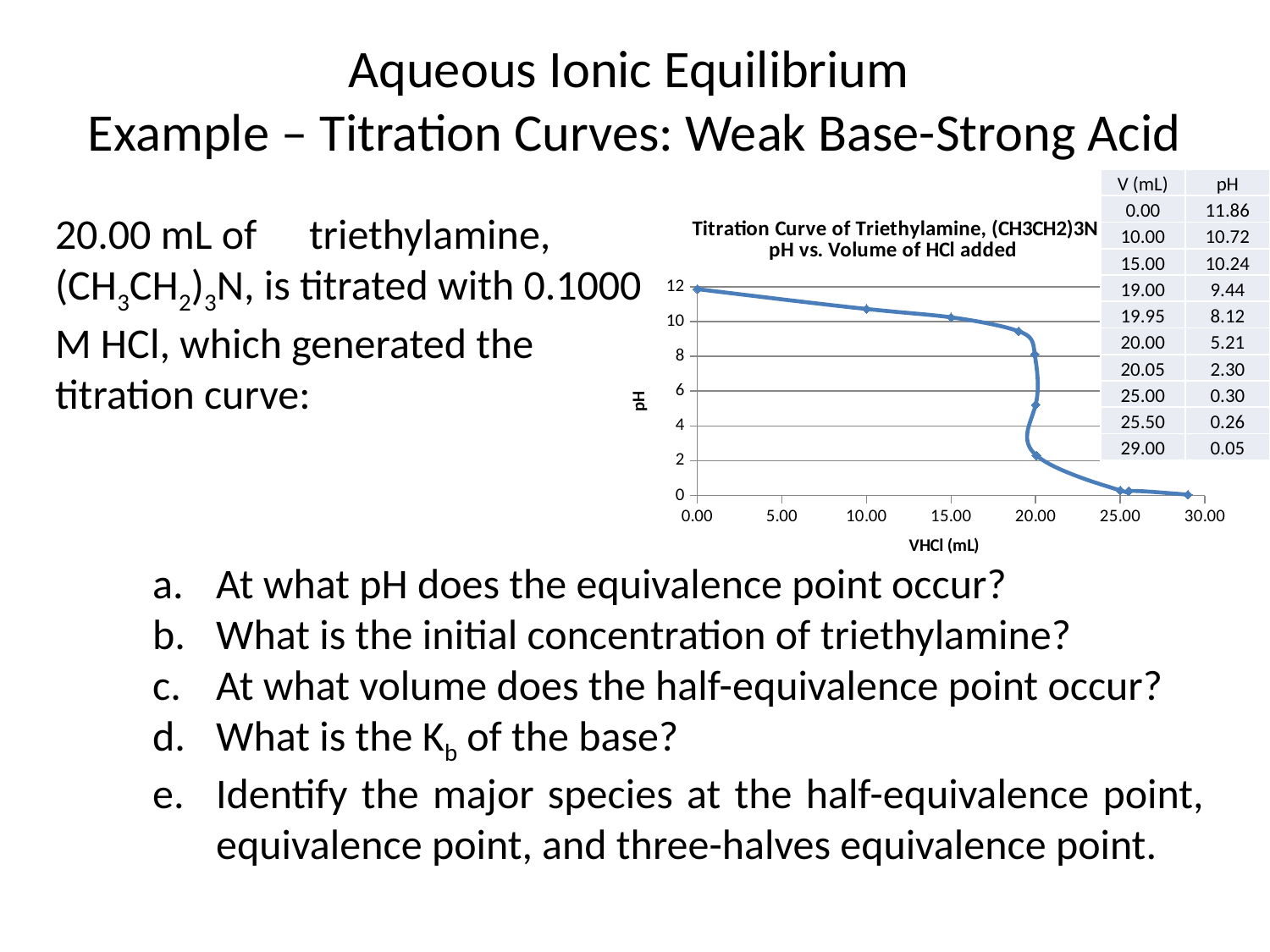
What is the pH at 20.00 mL of HCl added? 5.21 What is the pH when 0.00 mL of HCl has been added? 11.86 What is the pH at 29.00 mL of HCl added? 0.05 Does the pH rise or fall as the volume of HCl added increases? fall At which volume of HCl is the pH highest? 0.00 mL What is the difference in pH between 19.95 mL and 20.00 mL of HCl added? 2.91 At which volume of HCl is the pH lowest? 29.00 mL What is the pH at 19.95 mL of HCl added? 8.12 Which has the higher pH: 10.00 mL or 15.00 mL of HCl added? 10.00 mL How many data points are plotted on the titration curve? 10 What type of chart is shown on the slide? line chart Is the pH at 25.00 mL of HCl added greater or less than 2? less